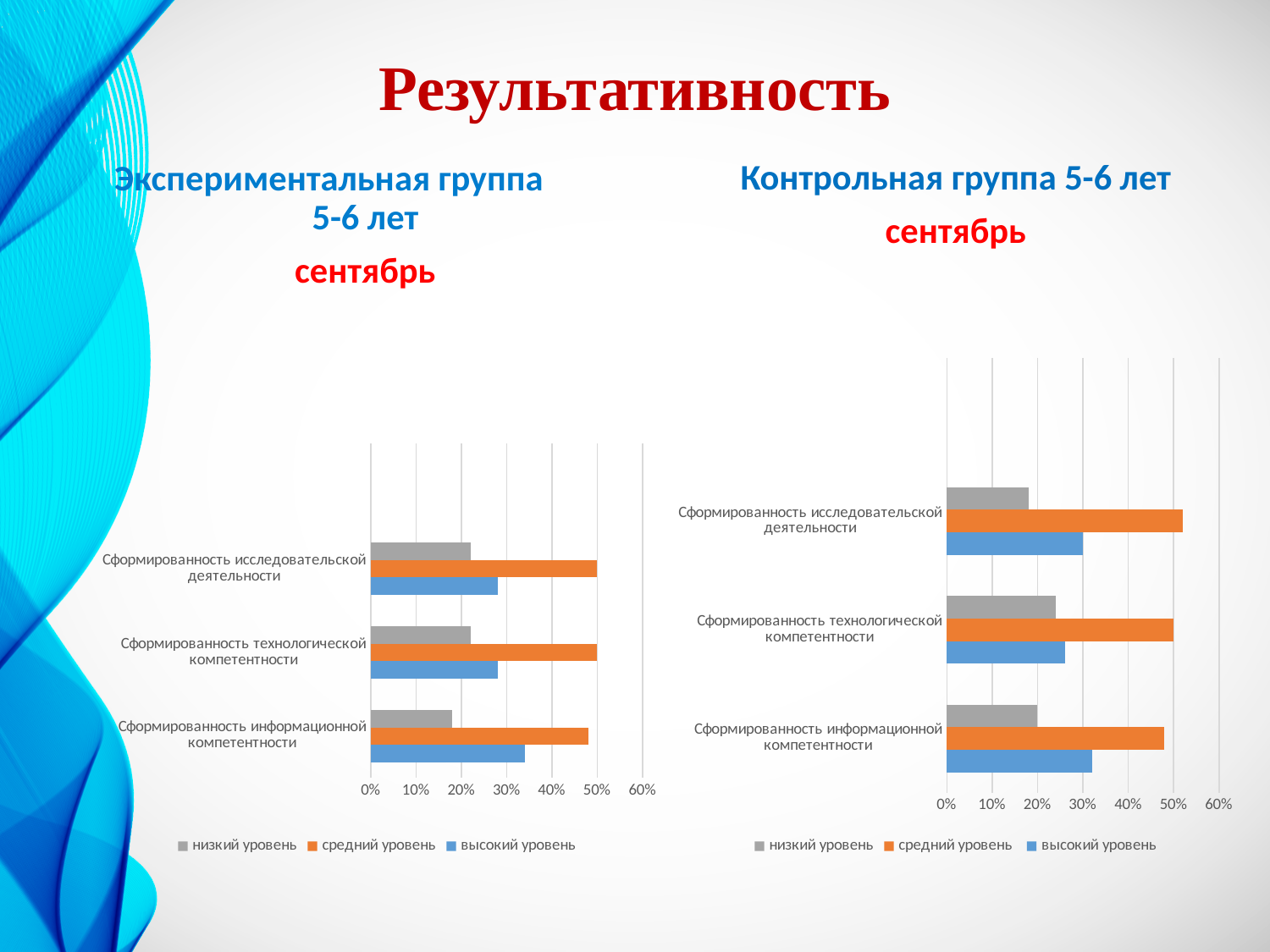
On the right chart (Контрольная группа), is the value of высокий уровень for Сформированность технологической компетентности greater or less than 30%? less How many categories are shown on the right chart (Контрольная группа 5-6 лет, сентябрь)? 3 On the left chart (Экспериментальная группа), which is larger for Сформированность исследовательской деятельности: средний уровень or высокий уровень? средний уровень On the left chart (Экспериментальная группа), is the value of низкий уровень for Сформированность информационной компетентности greater or less than 20%? less On the right chart (Контрольная группа), is the value of низкий уровень for Сформированность технологической компетентности greater or less than 20%? greater On the right chart (Контрольная группа), which series has the lowest value for Сформированность информационной компетентности? низкий уровень What kind of chart is the left chart (Экспериментальная группа 5-6 лет, сентябрь)? bar chart How many series does the legend of the left chart (Экспериментальная группа) list? 3 On the right chart (Контрольная группа), what colour represents средний уровень in the legend? orange On the left chart (Экспериментальная группа), which series has the highest value for Сформированность информационной компетентности? средний уровень